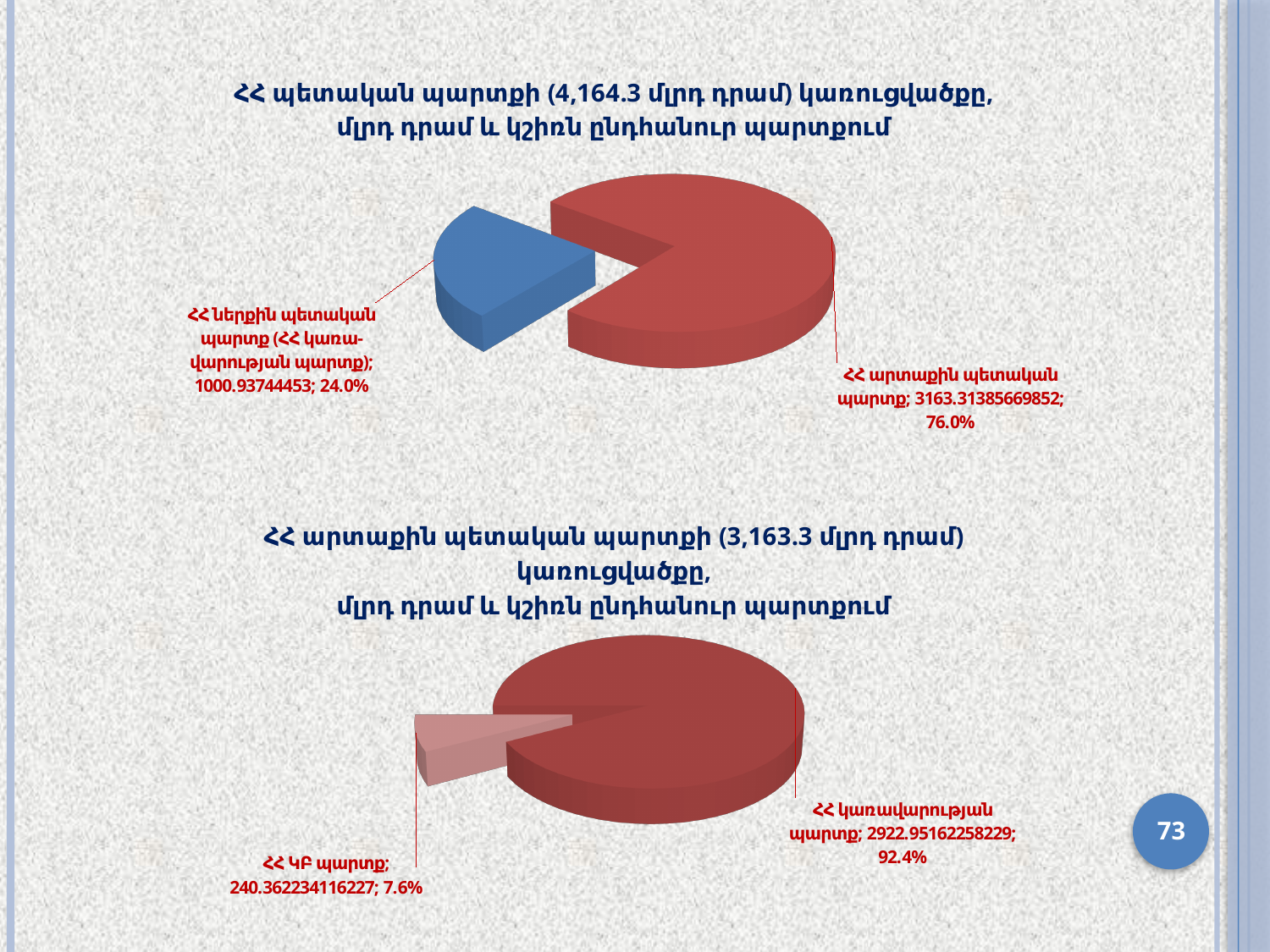
In the bottom pie chart, what value is printed for "ՀՀ կառավարության պարտք"? 2922.95162258229 In the top pie chart, what share does the slice labelled "ՀՀ արտաքին պետական պարտք" have? 76.0% What type of chart is the top chart on the slide? Pie chart In the top pie chart, what value is printed for "ՀՀ ներքին պետական պարտք (ՀՀ կառավարության պարտք)"? 1000.93744453 In the top pie chart, which slice is the largest? ՀՀ արտաքին պետական պարտք In the top pie chart, what value is printed for "ՀՀ արտաքին պետական պարտք"? 3163.31385669852 In the bottom pie chart, what share does the slice labelled "ՀՀ ԿԲ պարտք" have? 7.6% How many slices does the top pie chart have? 2 In the bottom pie chart, which slice is the smallest? ՀՀ ԿԲ պարտք In the top pie chart, what share does the slice labelled "ՀՀ ներքին պետական պարտք (ՀՀ կառավարության պարտք)" have? 24.0% In the bottom pie chart, which is larger: "ՀՀ ԿԲ պարտք" or "ՀՀ կառավարության պարտք"? ՀՀ կառավարության պարտք What type of chart is the bottom chart on the slide? Pie chart